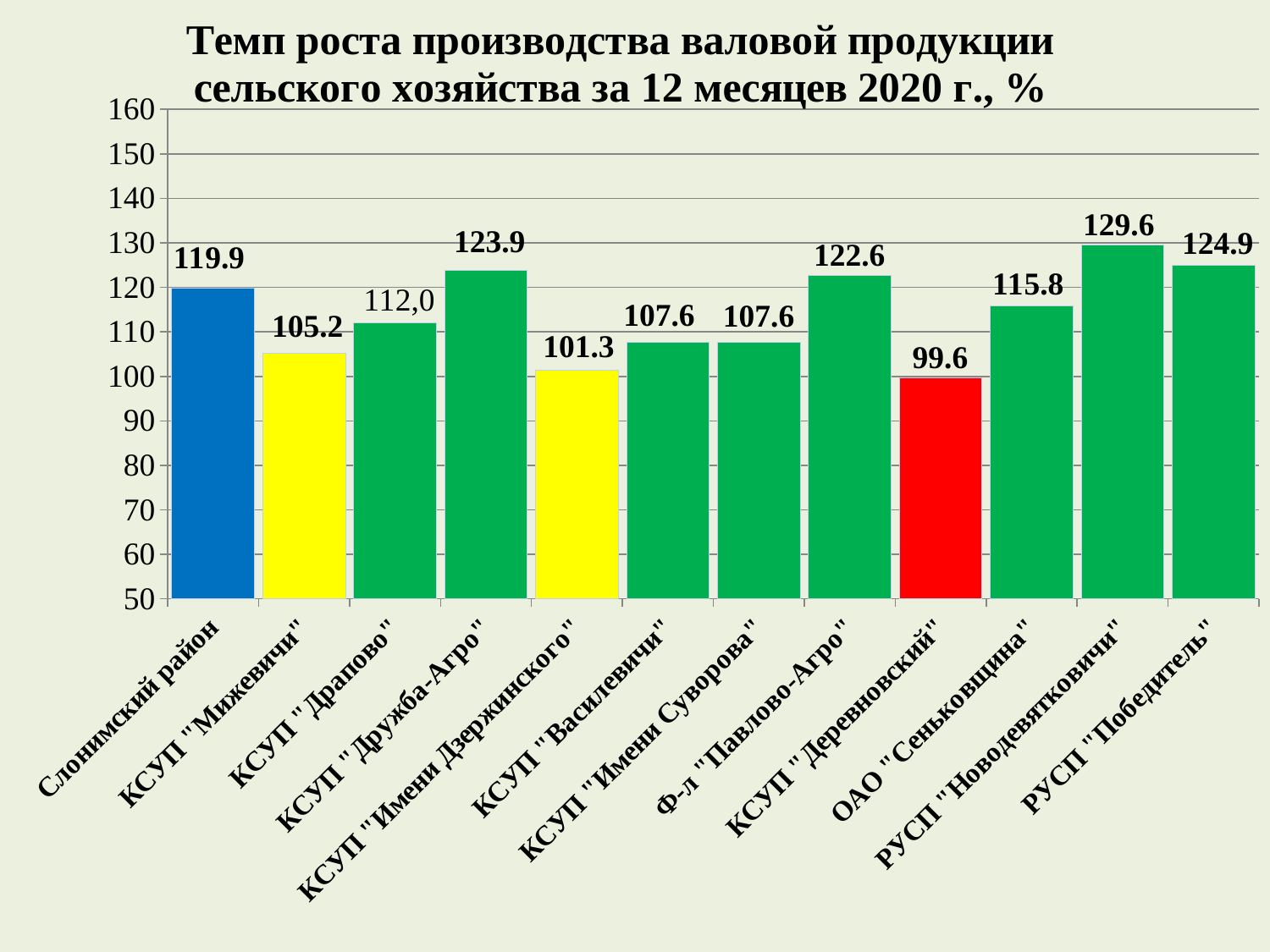
What is the difference between the values for Слонимский район and КСУП "Мижевичи"? 14.7 What is the difference between the values for РУСП "Новодевятковичи" and КСУП "Деревновский"? 30 What colour is the bar for КСУП "Деревновский"? Red What type of chart is shown on the slide? Bar chart Which is larger, the value for КСУП "Дружба-Агро" or Ф-л "Павлово-Агро"? КСУП "Дружба-Агро" Is the value for ОАО "Сеньковщина" greater or less than 110? greater How many organisations (categories) are shown on the chart? 12 What is the value for Слонимский район? 119.9 Which organisation has the highest growth rate? РУСП "Новодевятковичи" What is the value for КСУП "Деревновский"? 99.6 Which organisation has the lowest growth rate? КСУП "Деревновский" What is the value for РУСП "Победитель"? 124.9